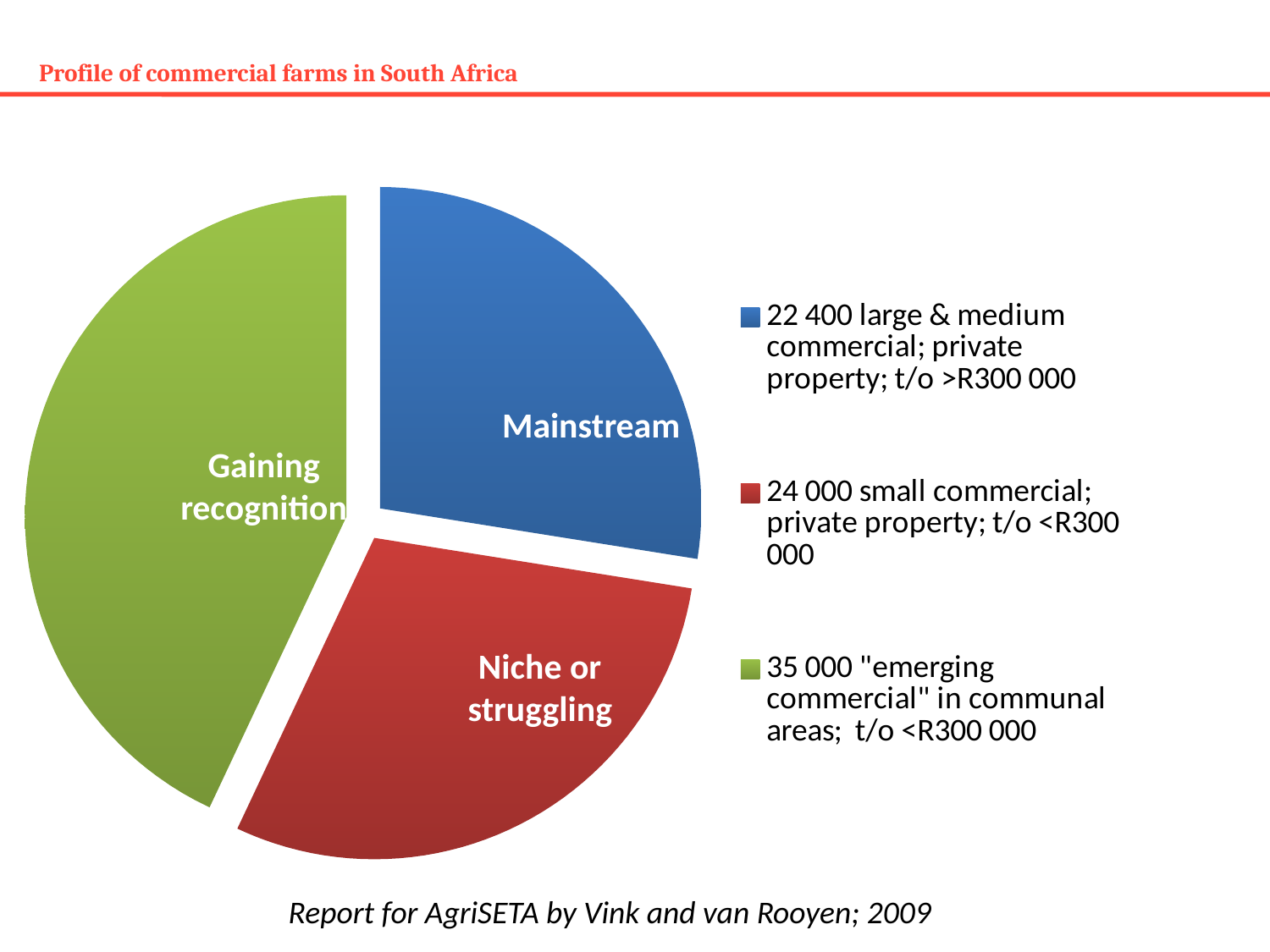
What is the total number of farms across all three slices? 81 400 Which is larger: the number of small commercial farms or the number of large & medium commercial farms? small commercial farms How many "emerging commercial" farms in communal areas are shown in the legend? 35 000 What colour is the Mainstream slice? blue What is the difference between the number of "emerging commercial" farms and the number of small commercial farms? 11 000 How many slices does the pie chart have? 3 How many large & medium commercial farms (private property; t/o >R300 000) are shown in the legend? 22 400 How many entries does the legend list? 3 How many small commercial farms (private property; t/o <R300 000) are shown in the legend? 24 000 Which slice of the pie chart is the largest? Gaining recognition Which slice of the pie chart is the smallest? Mainstream What kind of chart is shown on the slide? pie chart